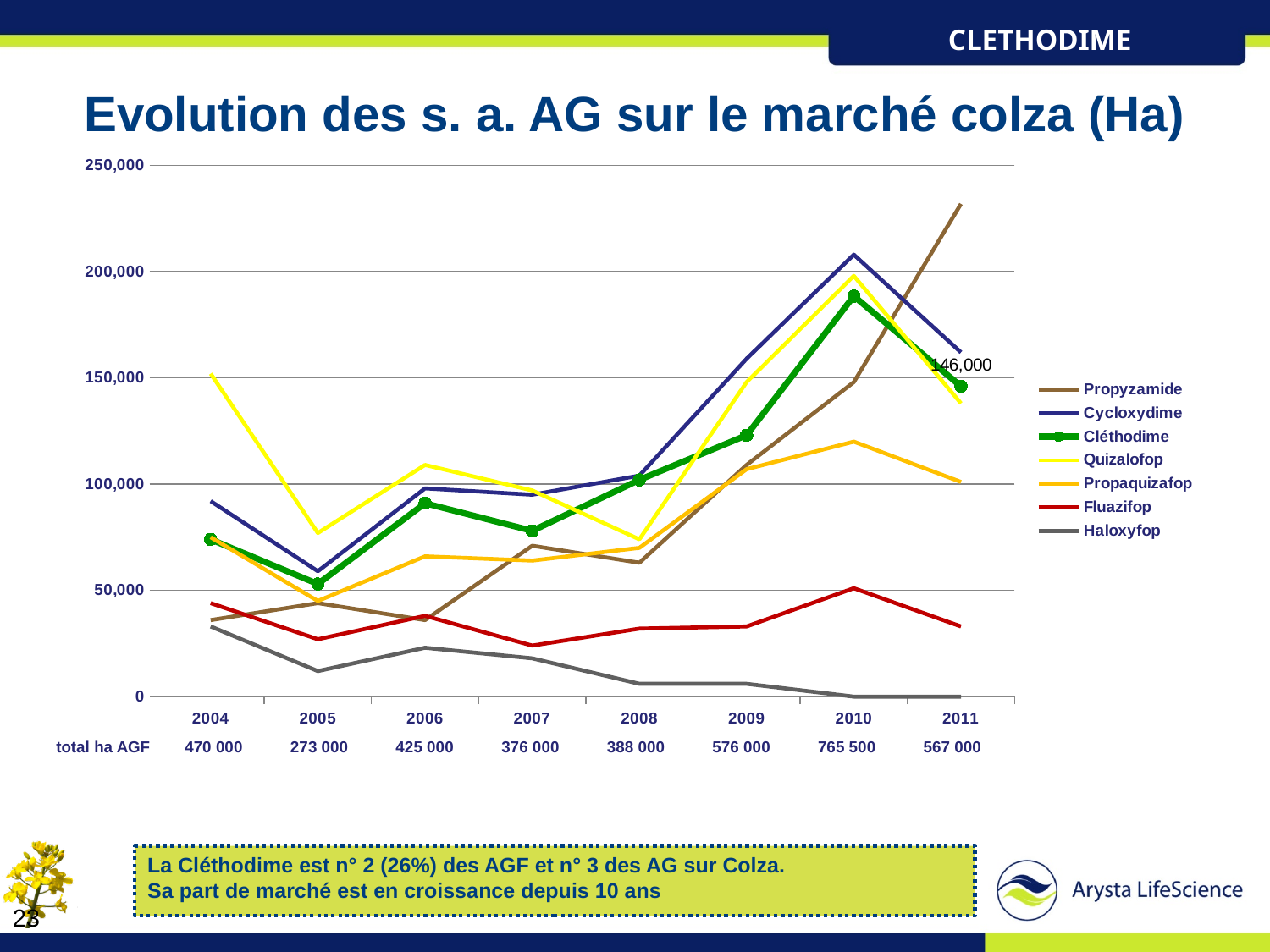
Which series has the highest value in 2004? Quizalofop What is the title of the chart? Evolution des s. a. AG sur le marché colza (Ha) How many series does the legend list? 7 Is the value for Fluazifop in 2007 greater or less than 50,000? less Is the value for Propyzamide in 2011 greater or less than 200,000? greater What kind of chart is shown on the slide? line chart Which series has the lowest value in 2011? Haloxyfop Does the Haloxyfop line rise or fall from 2004 to 2011? fall In 2010, which is larger: Cycloxydime or Fluazifop? Cycloxydime What is the value for Cléthodime in 2011? 146,000 How many years are shown on the x axis? 8 Which series has the highest value in 2011? Propyzamide